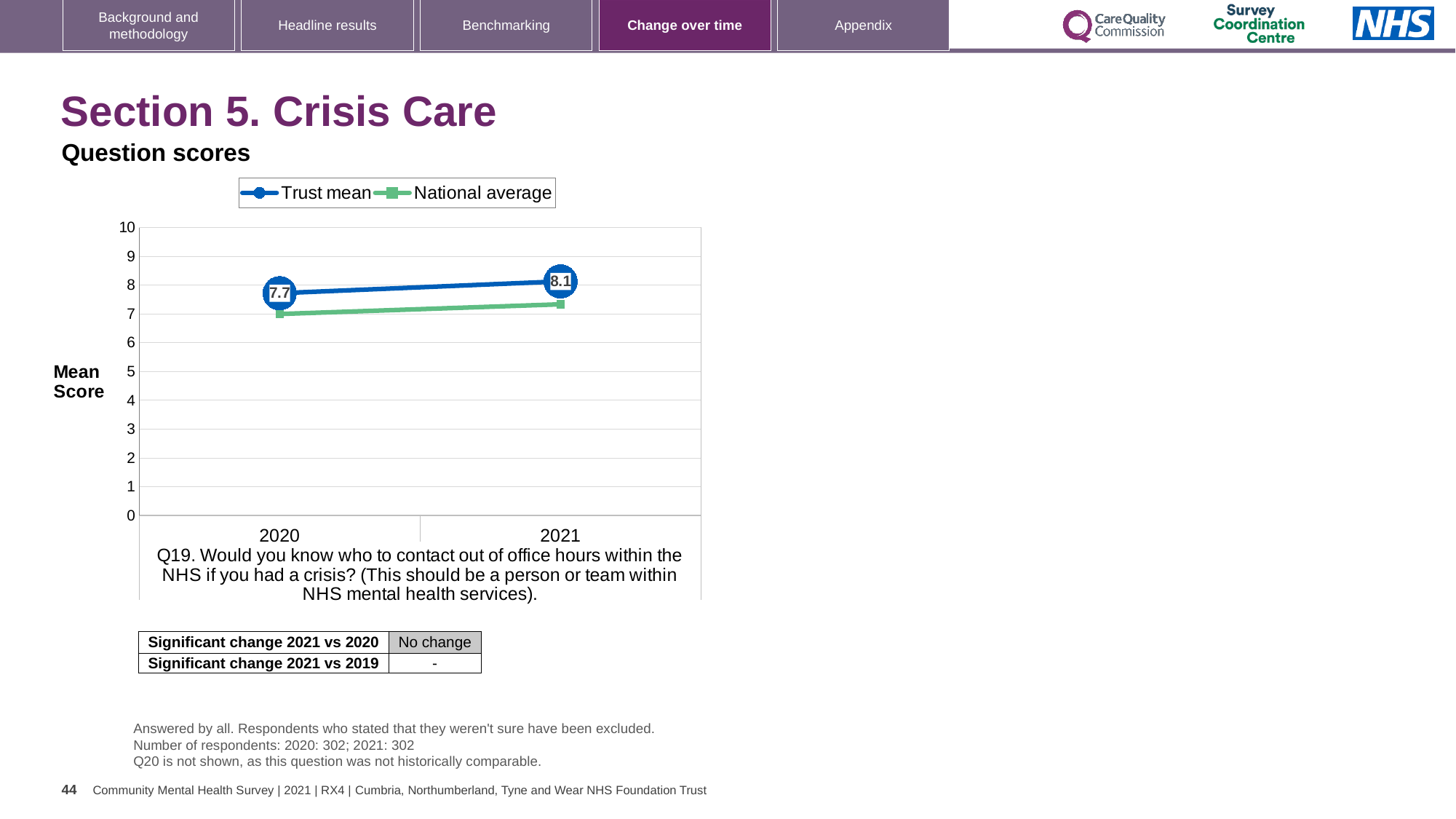
In 2021, which is higher: the Trust mean or the National average? Trust mean Does the Trust mean line rise or fall from 2020 to 2021? rises What type of chart is shown on the slide? line chart What is the Trust mean score for 2021? 8.1 What is the label on the y axis of the chart? Mean Score Which year has the higher Trust mean score, 2020 or 2021? 2021 How many series does the chart legend list? 2 By how much did the Trust mean score change from 2020 to 2021? 0.4 How many years are plotted on the x axis of the chart? 2 Is the National average value for 2020 greater or less than 8? less Is the National average value for 2021 greater or less than 6? greater What is the Trust mean score for 2020? 7.7